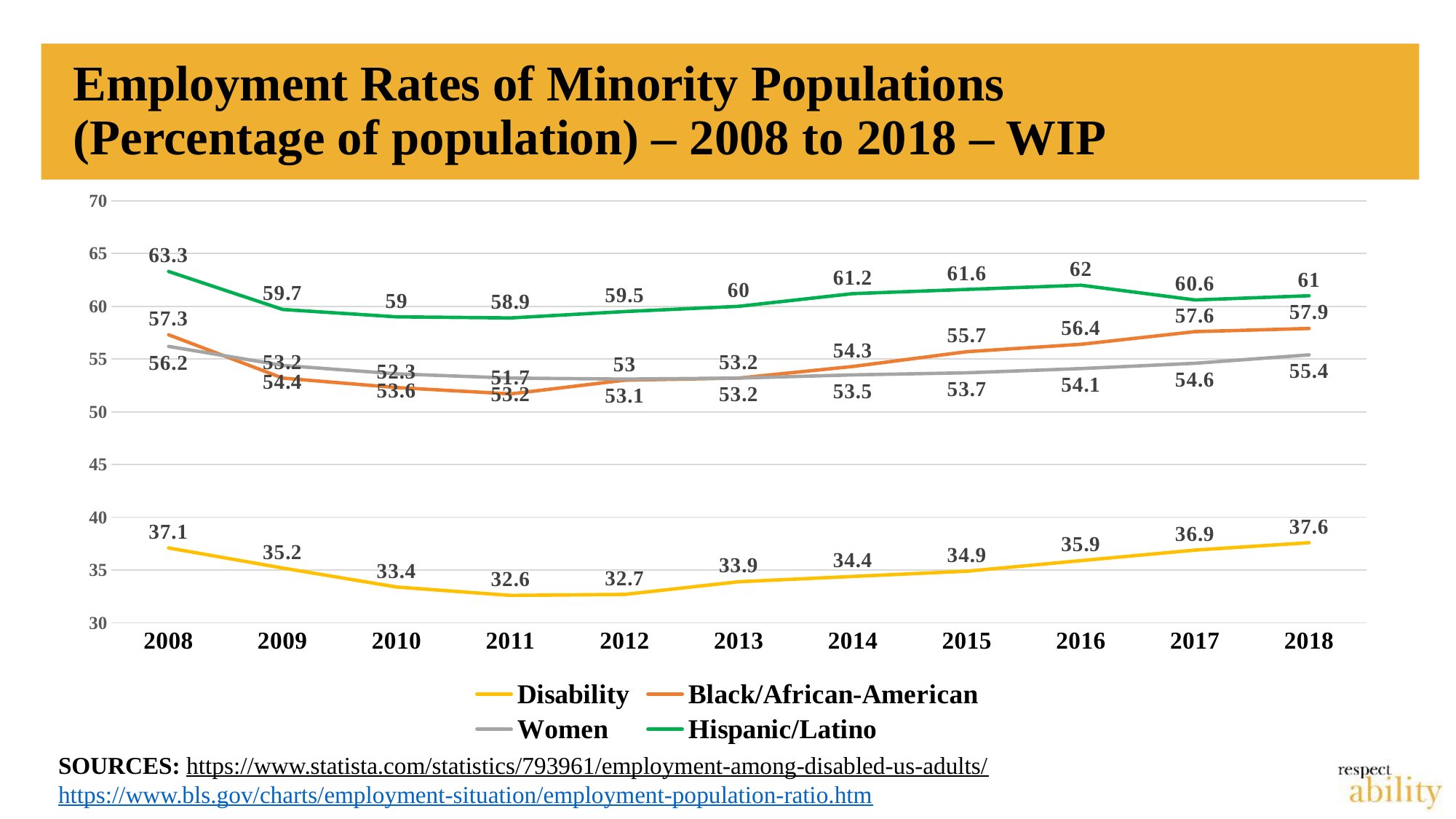
In which year is the Hispanic/Latino employment rate highest? 2008 How many series does the legend list? 4 Which is larger in 2016, the Black/African-American rate or the Women rate? Black/African-American How many years are plotted on the x axis? 11 What is the employment rate for Disability in 2011? 32.6 What type of chart is shown on the slide? Line chart In which year is the Disability employment rate lowest? 2011 What is the employment rate for Hispanic/Latino in 2008? 63.3 What is the employment rate for Women in 2012? 53.1 Which colour is used for the Disability line? Yellow What is the difference between the Hispanic/Latino and Disability employment rates in 2018? 23.4 What is the employment rate for Black/African-American in 2018? 57.9